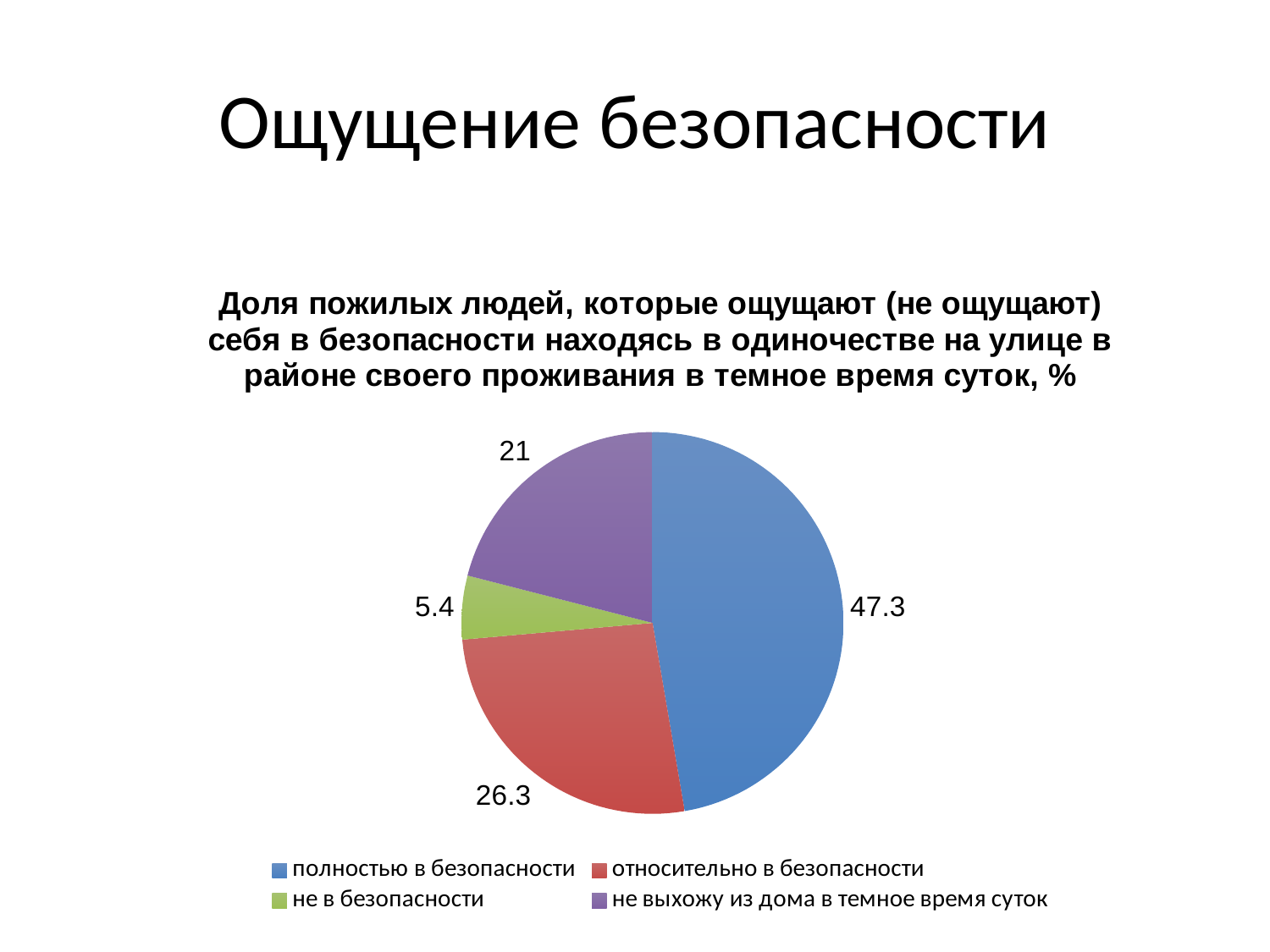
What type of chart is shown on the slide? pie chart How many slices does the pie chart have? 4 What colour is the slice for 'не в безопасности'? green Which category has the smallest slice of the pie? не в безопасности What value is shown for the slice 'не выхожу из дома в темное время суток'? 21 What value is shown for the slice 'относительно в безопасности'? 26.3 What value is shown for the slice 'полностью в безопасности'? 47.3 What is the difference between the values for 'полностью в безопасности' and 'относительно в безопасности'? 21 Which category has the largest slice of the pie? полностью в безопасности What is the difference between the values for 'относительно в безопасности' and 'не выхожу из дома в темное время суток'? 5.3 Which is larger: the value for 'не выхожу из дома в темное время суток' or the value for 'не в безопасности'? не выхожу из дома в темное время суток What value is shown for the slice 'не в безопасности'? 5.4